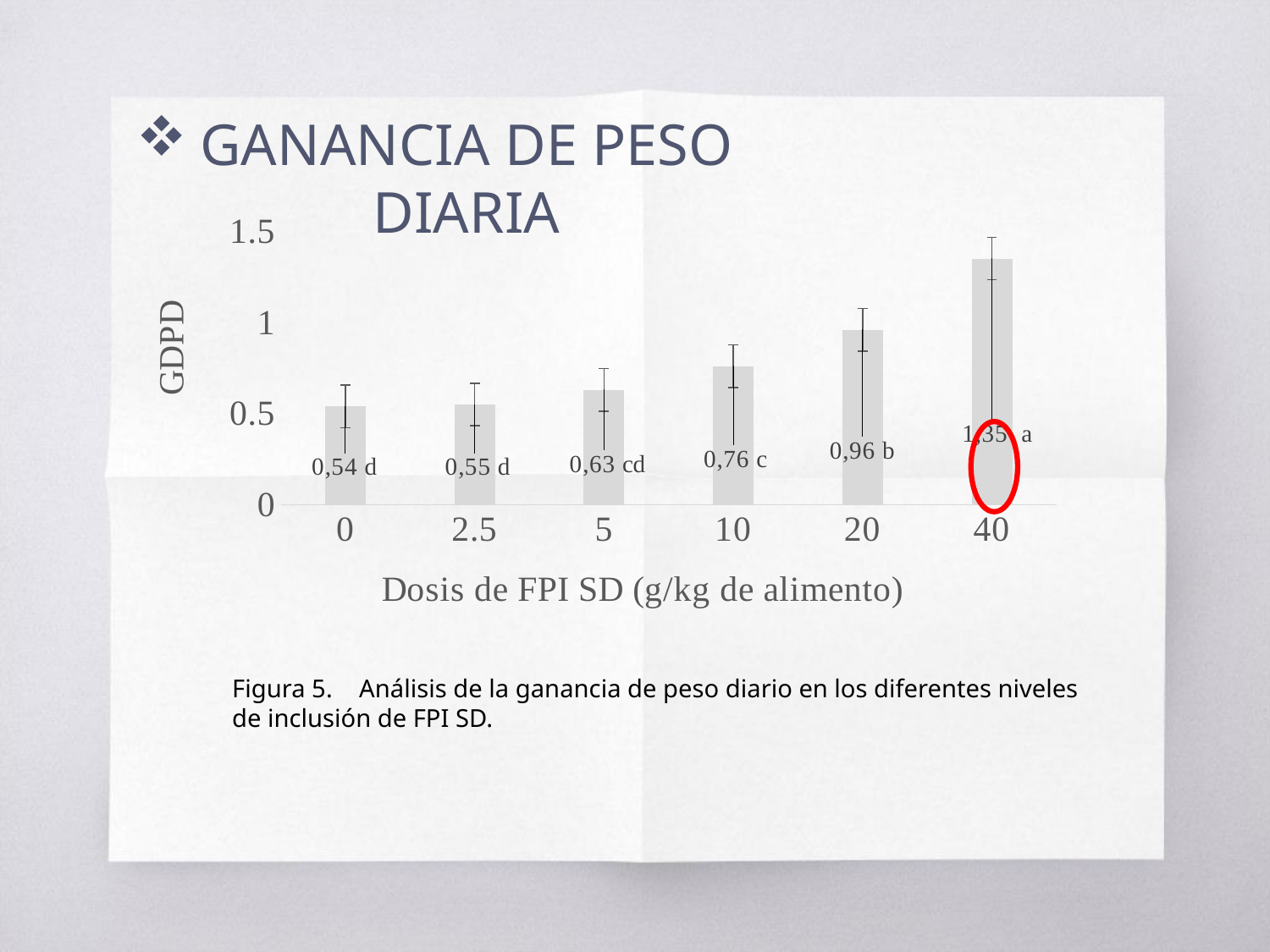
What is the GDPD value for the 0 g/kg dose? 0,54 What kind of chart is shown on the slide? bar chart Which has a larger GDPD, the 5 g/kg dose or the 20 g/kg dose? 20 g/kg What is the difference in GDPD between the 20 g/kg dose and the 10 g/kg dose? 0,20 Is the GDPD value for the 40 g/kg dose greater or less than 1? greater What is the GDPD value for the 10 g/kg dose? 0,76 Do the GDPD values rise or fall as the dose of FPI SD increases? rise What is the difference in GDPD between the 40 g/kg dose and the 0 g/kg dose? 0,81 How many dose levels are shown on the x axis? 6 What is the GDPD value for the 40 g/kg dose of FPI SD? 1,35 Which dose of FPI SD has the highest GDPD? 40 What is the GDPD value for the 20 g/kg dose? 0,96